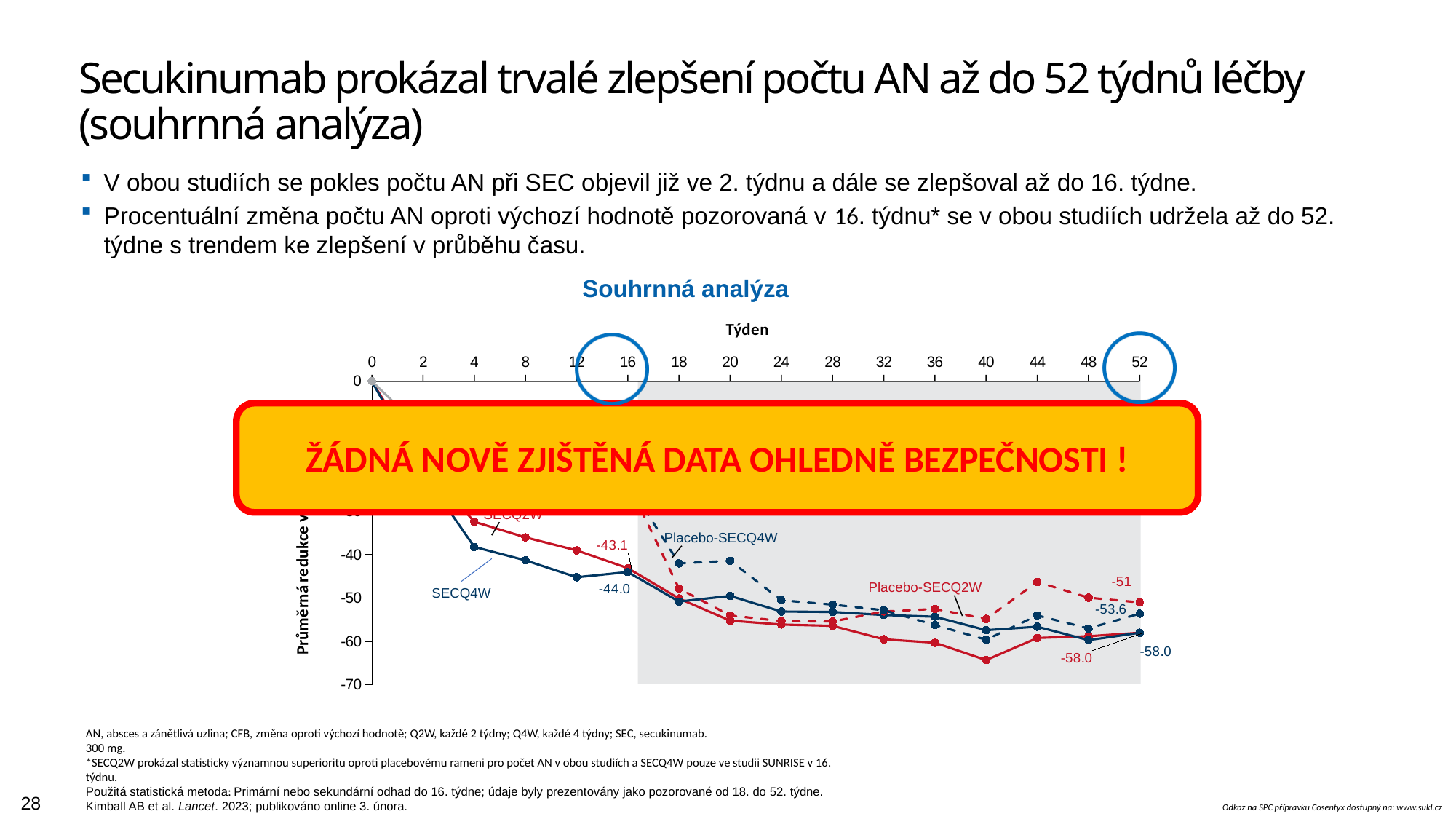
At week 52, which series has the lower value: Placebo-SECQ2W or SECQ4W? SECQ4W What is the labelled value for SECQ4W at week 16? -44.0 What is the labelled value for SECQ2W at week 16? -43.1 What is the labelled value for SECQ2W at week 52? -58.0 How many series are plotted in the chart? 5 What is the labelled value for Placebo-SECQ2W at week 52? -51 By how much did the SECQ2W value change between week 16 (-43.1) and week 52 (-58.0)? 14.9 Is the value for Placebo-SECQ2W at week 44 greater or less than -50? greater What type of chart is shown under the heading 'Souhrnná analýza'? line chart What is the difference between the week 52 values of Placebo-SECQ2W (-51) and Placebo-SECQ4W (-53.6)? 2.6 What is the labelled value for Placebo-SECQ4W at week 52? -53.6 Do the plotted values generally rise or fall as the weeks increase? fall